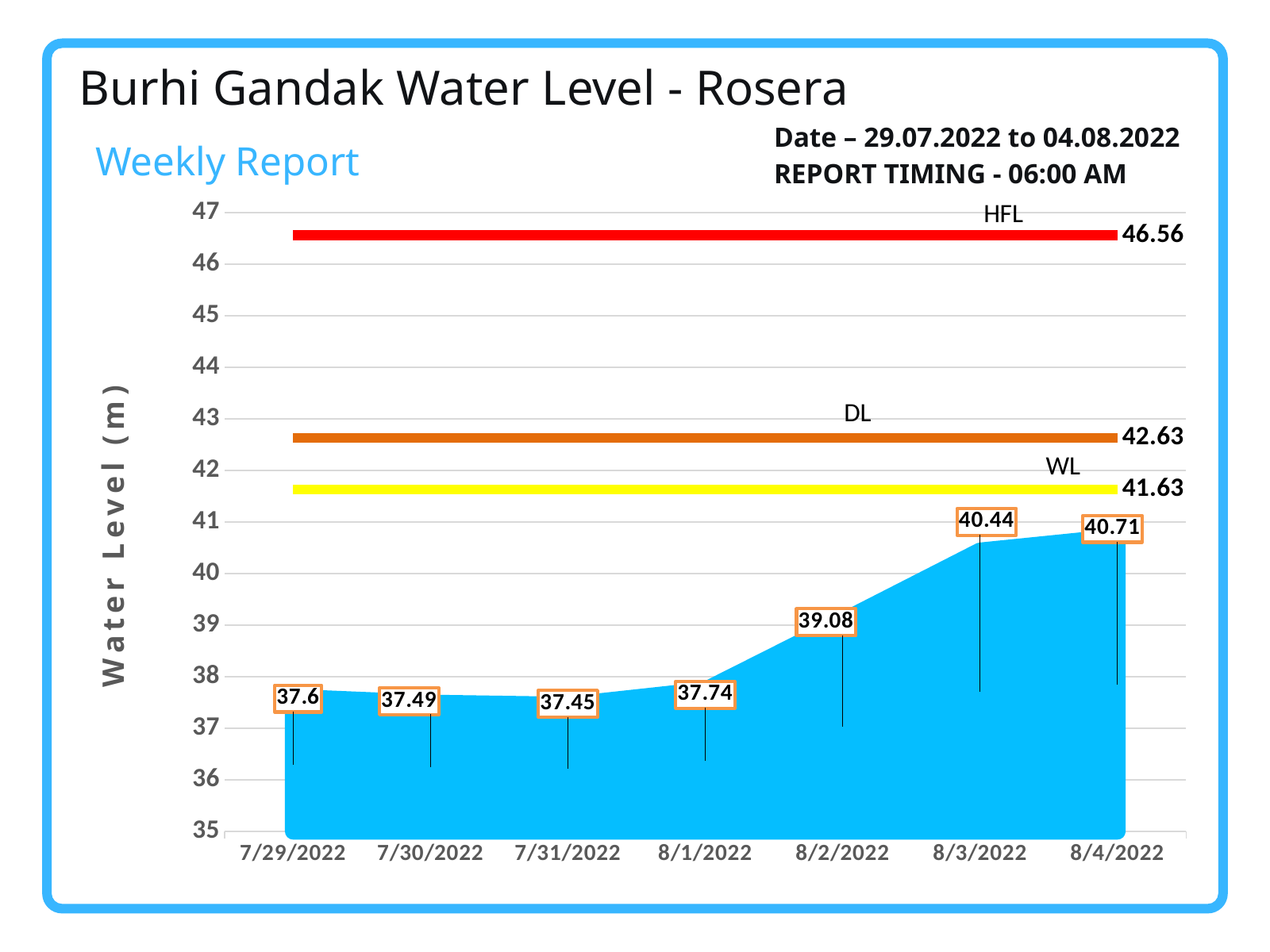
How many dates are plotted on the chart? 7 On which date is the water level lowest? 7/31/2022 Which date has a higher water level, 8/3/2022 or 8/1/2022? 8/3/2022 What is the value of the HFL line? 46.56 What is the value of the DL line? 42.63 Is the water level on 8/3/2022 greater or less than 40? greater What is the water level on 8/2/2022? 39.08 Does the water level rise or fall from 8/1/2022 to 8/4/2022? rise What is the water level on 8/4/2022? 40.71 What is the water level on 7/29/2022? 37.6 What is the difference between the water level on 8/4/2022 and on 7/29/2022? 3.11 On which date is the water level highest? 8/4/2022